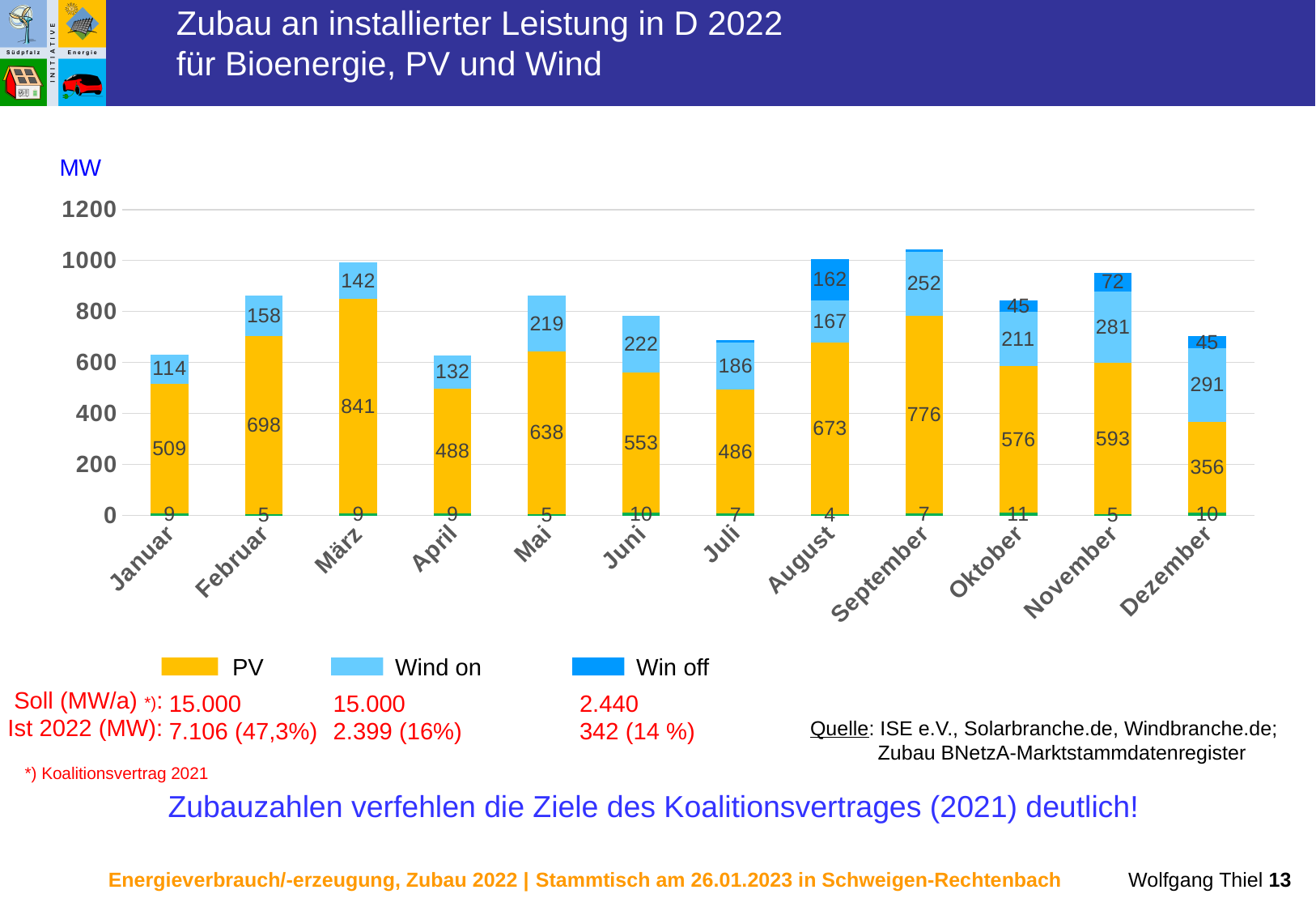
What is the Win off value for August? 162 How many series does the legend list? 3 Is the total height of the Januar bar greater or less than 800? less Which is larger, the Wind on value for Februar or the Wind on value for Mai? Mai How many months are shown on the x axis? 12 What is the total of the März bar (all labelled segments)? 992 Which month has the lowest PV value? Dezember What is the PV value for März? 841 Which month has the highest PV value? März What is the Wind on value for Dezember? 291 What is the difference between the PV value for März and the PV value for Dezember? 485 What kind of chart is shown on the slide? stacked bar chart